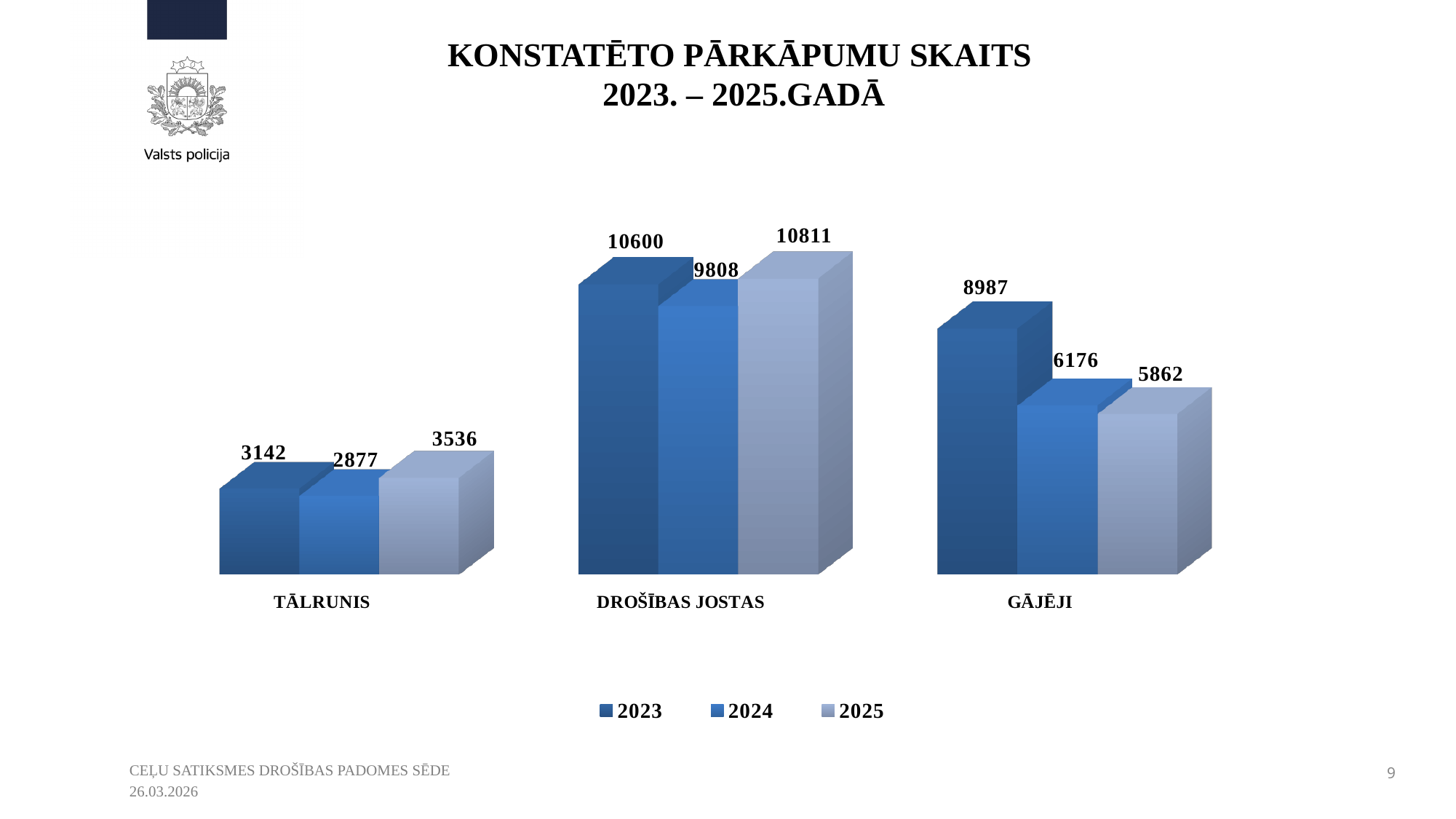
What is the value for TĀLRUNIS in 2023? 3142 Which category has the lowest value in 2025? TĀLRUNIS Which category has the highest value in 2023? DROŠĪBAS JOSTAS What kind of chart is shown on the slide? bar chart What is the difference between the 2023 and 2025 values for GĀJĒJI? 3125 How many categories are shown on the x axis? 3 What is the value for GĀJĒJI in 2024? 6176 How many series does the legend list? 3 Which is larger for DROŠĪBAS JOSTAS: the 2023 value or the 2024 value? 2023 What is the title of the chart? KONSTATĒTO PĀRKĀPUMU SKAITS 2023. – 2025.GADĀ Do the values for GĀJĒJI rise or fall from 2023 to 2025? fall What is the value for DROŠĪBAS JOSTAS in 2025? 10811